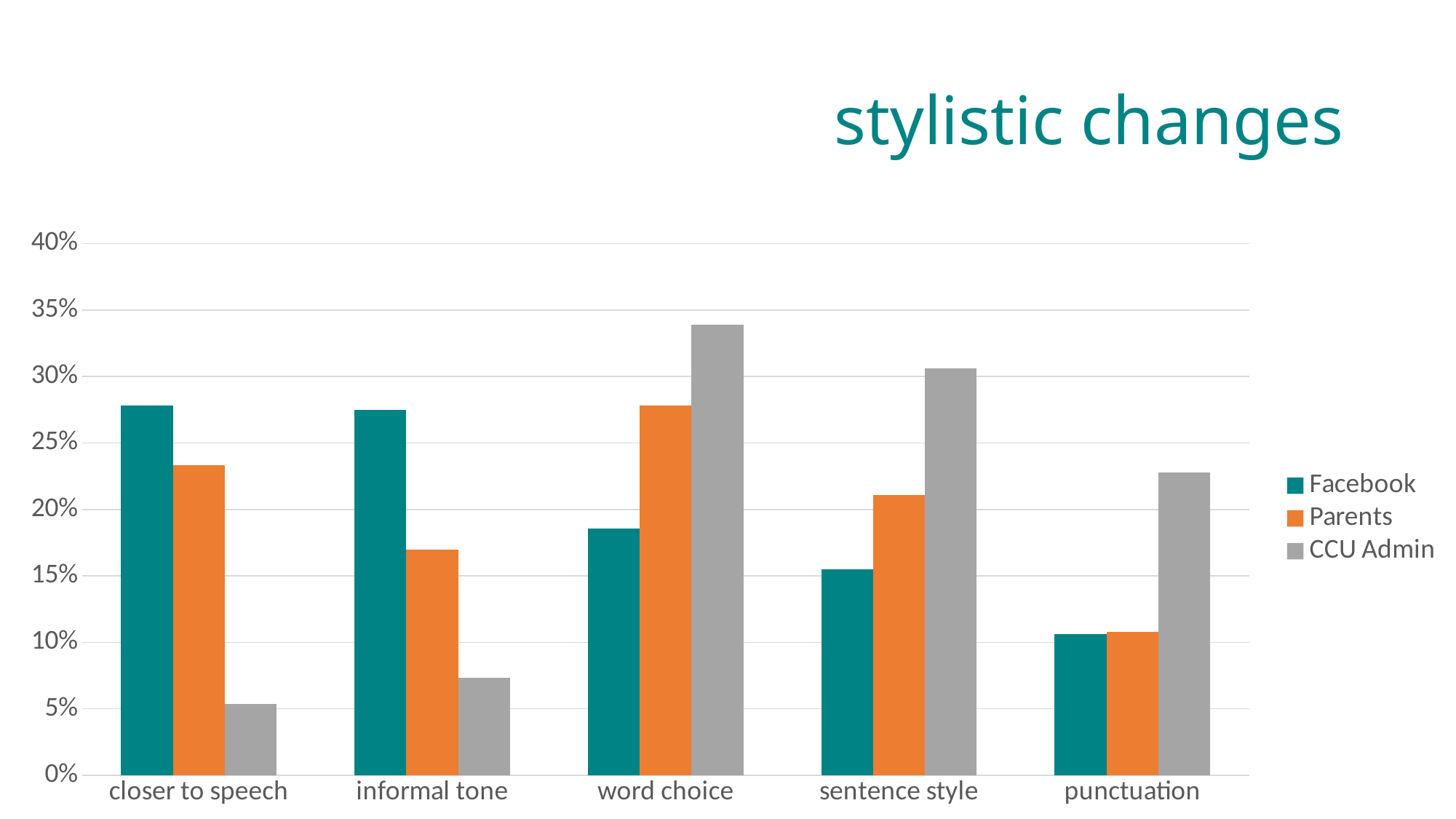
Is the CCU Admin value for word choice greater or less than 30%? greater How many series does the legend list? 3 What kind of chart is shown on the slide? bar chart Is the Facebook value for informal tone greater or less than 25%? greater For sentence style, which is larger: the Parents value or the CCU Admin value? CCU Admin For which category is the CCU Admin bar the highest? word choice For which category is the Facebook bar the lowest? punctuation How many categories are shown on the x axis? 5 What is the title of the chart? stylistic changes Is the CCU Admin value for closer to speech greater or less than 10%? less For closer to speech, which is larger: the Facebook value or the Parents value? Facebook Which series is shown in orange? Parents